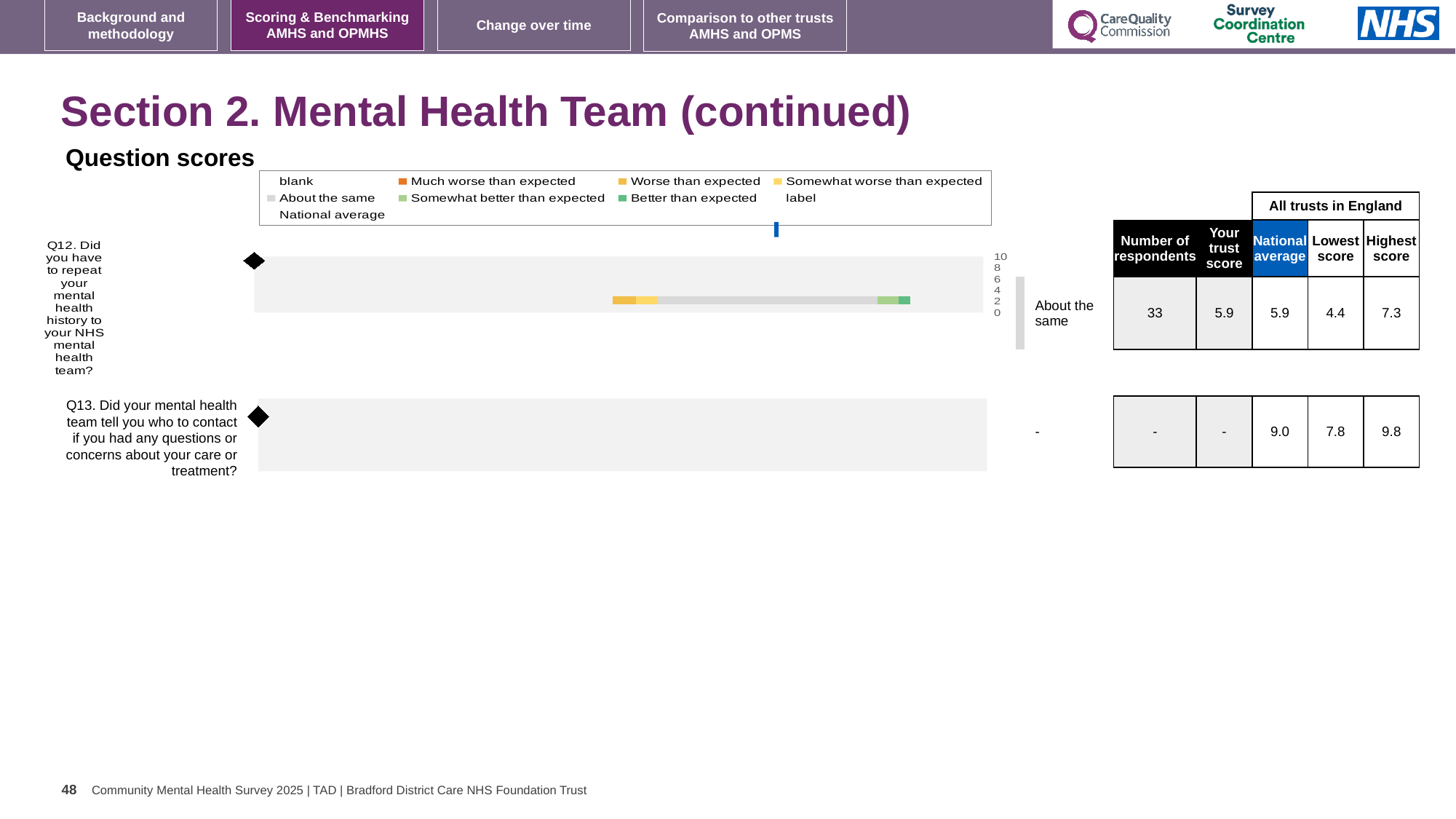
What is the lowest score among all trusts in England for Q12? 4.4 What kind of chart is used to show the question scores? Bar chart What is the highest score among all trusts in England for Q13? 9.8 What is the national average score for Q13 (Did your mental health team tell you who to contact if you had any questions or concerns about your care or treatment?)? 9.0 What is the trust's score for Q12 (Did you have to repeat your mental health history to your NHS mental health team?)? 5.9 How many questions are plotted in the question scores chart? 2 What is the national average score for Q12? 5.9 How many respondents answered Q12 according to the table? 33 What is the difference between the highest score and the lowest score for Q12? 2.9 What benchmark category is shown next to the Q12 bar? About the same What is the highest score among all trusts in England for Q12? 7.3 Which question has the higher national average score, Q12 or Q13? Q13